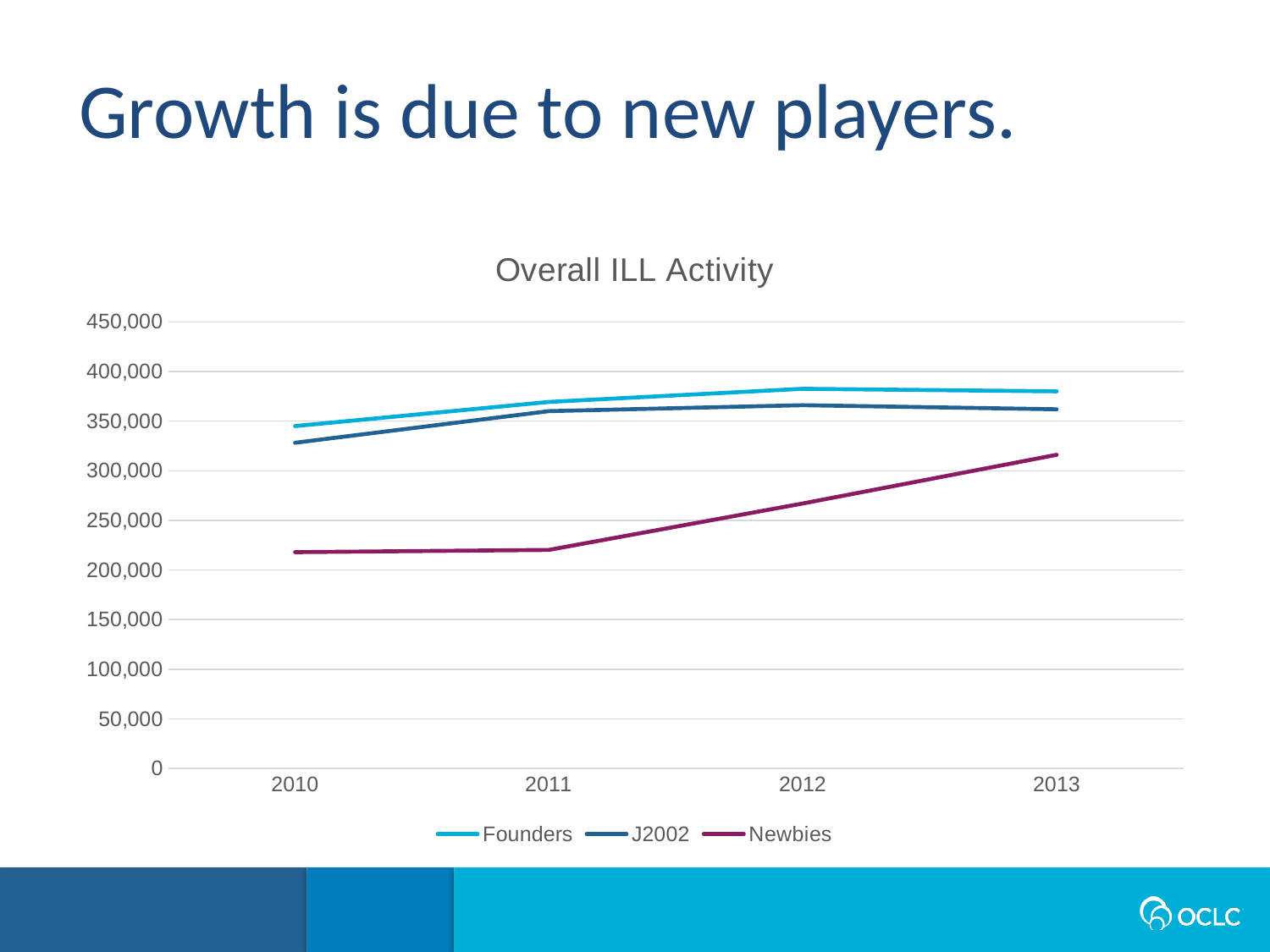
Is the value for Founders in 2012 greater or less than 350,000? greater What kind of chart is shown on the slide? line chart Which is larger in 2013, the value for Founders or the value for Newbies? Founders Is the value for J2002 in 2010 greater or less than 350,000? less Which series has the lowest value in 2013? Newbies What is the title of the chart? Overall ILL Activity Is the value for Newbies in 2013 greater or less than 300,000? greater How many series does the legend list? 3 How many years are shown on the x axis? 4 Which series has the highest value in 2010? Founders Do the values for Newbies rise or fall from 2011 to 2013? rise